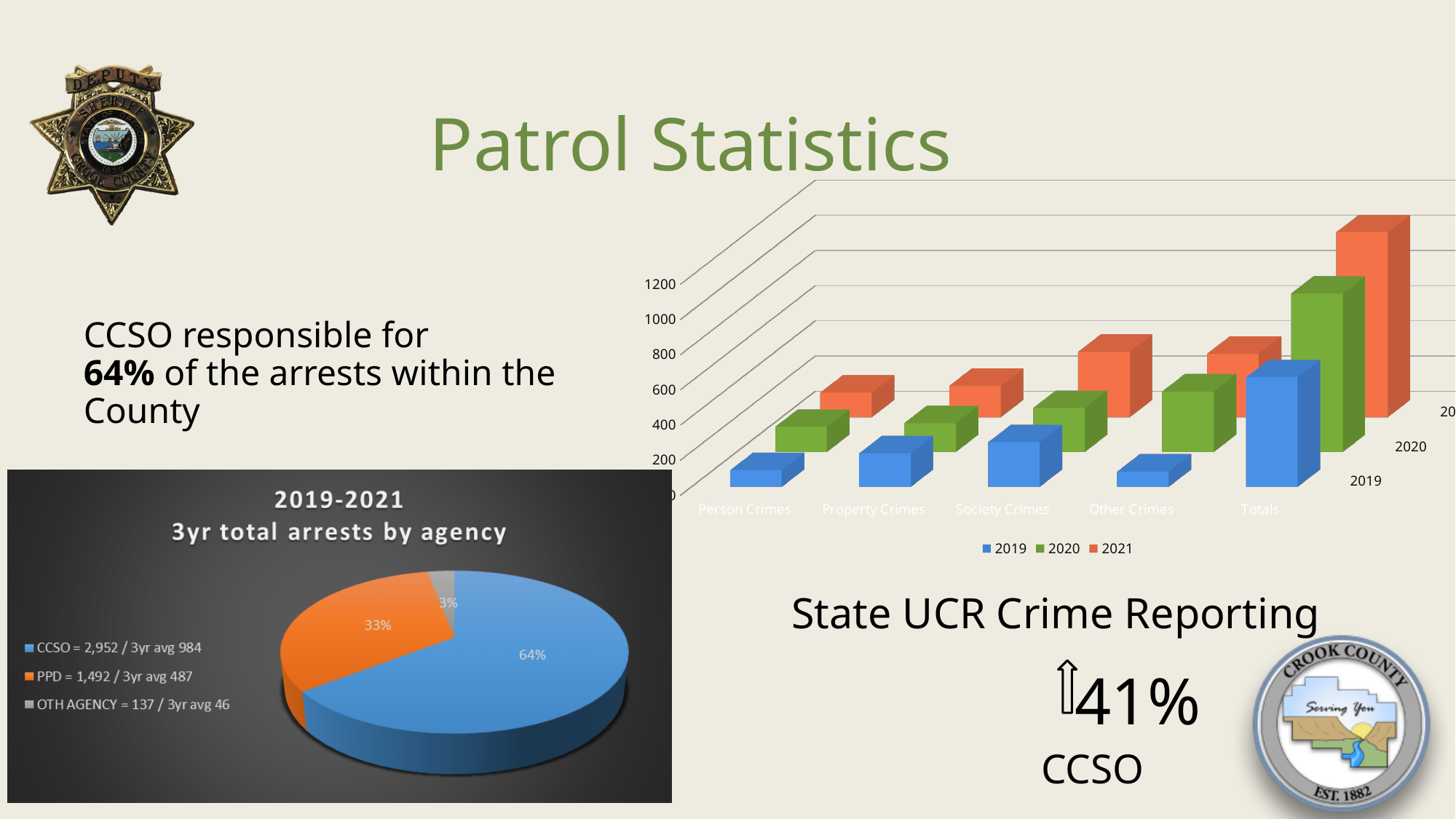
On the 'State UCR Crime Reporting' bar chart, which category has the highest value for 2021? Totals On the pie chart titled '2019-2021 3yr total arrests by agency', which agency has the largest share of arrests? CCSO On the pie chart titled '2019-2021 3yr total arrests by agency', what is the 3-year total number of arrests for CCSO shown in the legend? 2,952 On the pie chart titled '2019-2021 3yr total arrests by agency', how many agencies are shown? 3 On the pie chart titled '2019-2021 3yr total arrests by agency', what share of arrests is attributed to PPD? 33% On the pie chart titled '2019-2021 3yr total arrests by agency', what share of arrests is attributed to OTH AGENCY? 3% On the pie chart titled '2019-2021 3yr total arrests by agency', what is the 3yr avg for PPD shown in the legend? 487 What kind of chart is the 'State UCR Crime Reporting' chart on the right of the slide? Bar chart On the pie chart titled '2019-2021 3yr total arrests by agency', what share of arrests is attributed to CCSO? 64% On the 'State UCR Crime Reporting' bar chart, how many series does the legend list? 3 On the pie chart titled '2019-2021 3yr total arrests by agency', how many percentage points larger is the CCSO share than the PPD share? 31 On the pie chart titled '2019-2021 3yr total arrests by agency', which agency has the smallest share of arrests? OTH AGENCY